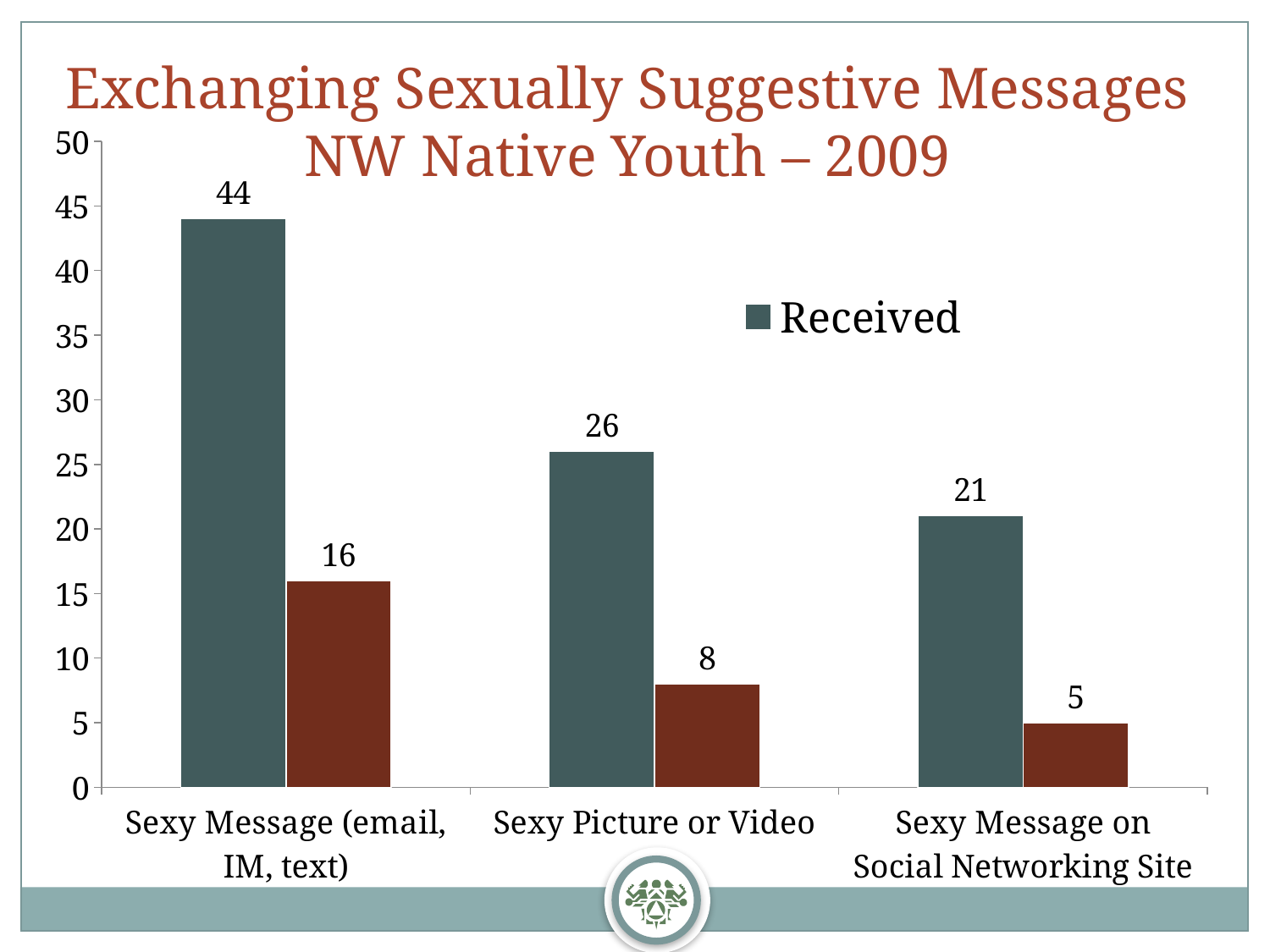
What is the Received value for Sexy Message on Social Networking Site? 21 What is the Received value for Sexy Message (email, IM, text)? 44 What kind of chart is shown on the slide? Bar chart What is the difference between the Received value for Sexy Message (email, IM, text) and the Received value for Sexy Picture or Video? 18 Which category has the highest Received value? Sexy Message (email, IM, text) Which category has the lowest Received value? Sexy Message on Social Networking Site How many categories are shown on the x axis? 3 What is the value of the dark red bar for Sexy Picture or Video? 8 What is the Received value for Sexy Picture or Video? 26 What is the only series name listed in the legend? Received Which is larger: the Received value for Sexy Picture or Video or the dark red bar for Sexy Message (email, IM, text)? Received value for Sexy Picture or Video What is the value of the dark red bar for Sexy Message on Social Networking Site? 5